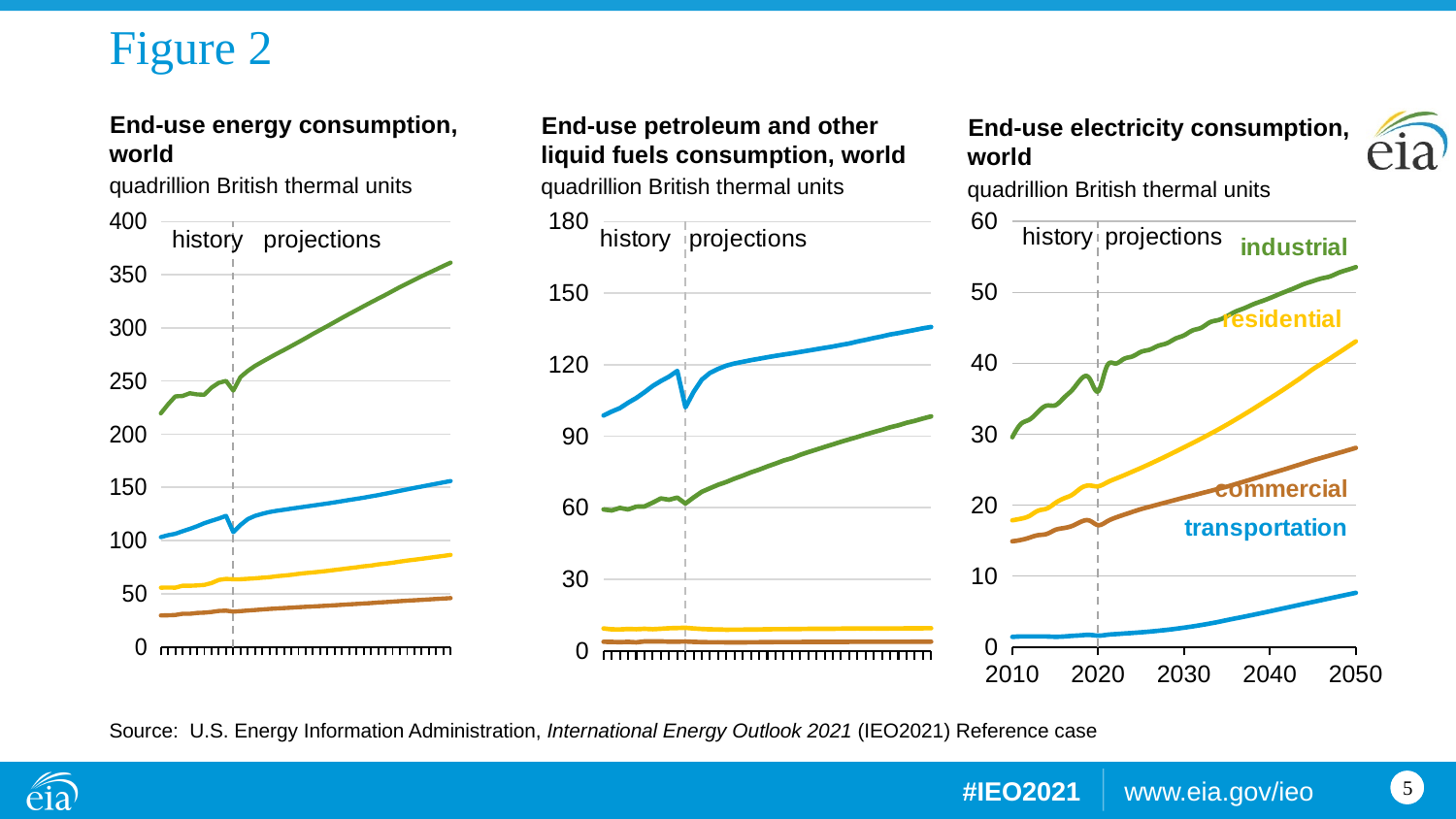
What unit is shown under the title of each chart on the slide? quadrillion British thermal units In the 'End-use electricity consumption, world' chart, does the industrial series rise or fall from 2010 to 2050? rise In the 'End-use electricity consumption, world' chart, which series has the highest value in 2050? industrial In the 'End-use petroleum and other liquid fuels consumption, world' chart, is the value of the blue line in 2050 greater or less than 120? greater In the 'End-use electricity consumption, world' chart, which is larger in 2050, residential or commercial? residential In the 'End-use electricity consumption, world' chart, how many labeled series are plotted? 4 In the 'End-use electricity consumption, world' chart, which series has the lowest value in 2050? transportation In the 'End-use electricity consumption, world' chart, is the value for residential in 2010 greater or less than 20? less What kind of chart is the 'End-use electricity consumption, world' chart? line chart In the 'End-use electricity consumption, world' chart, is the value for transportation in 2050 greater or less than 10? less How many charts are shown on the slide? 3